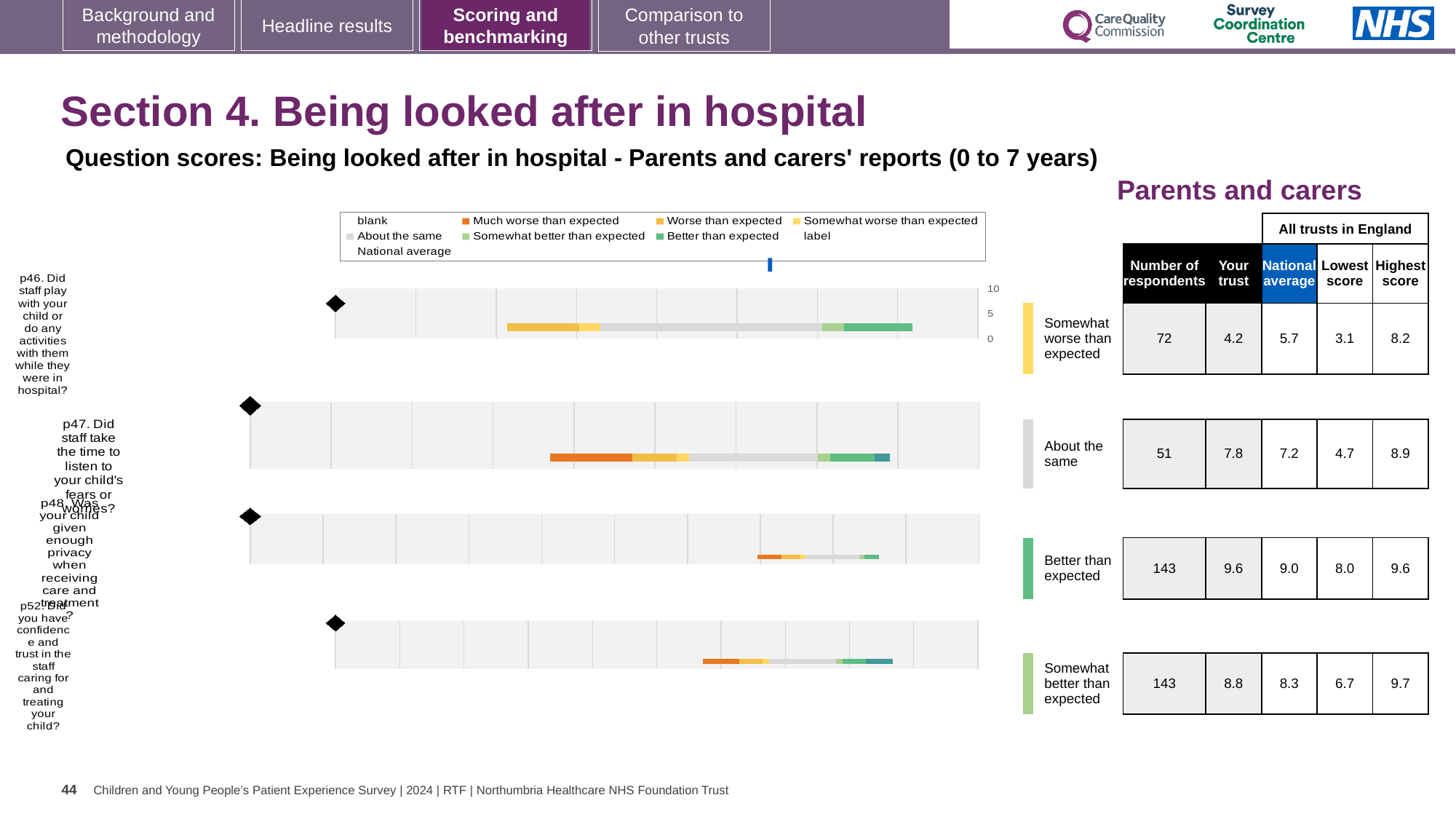
Which question chart has the lowest 'Your trust' score? p46 For the p46 chart, what is the difference between the national average (5.7) and the 'Your trust' score (4.2)? 1.5 For the p48 chart, which is larger: the 'Your trust' score or the national average? Your trust What kind of chart is used to show the question scores for p46 to p52? Bar chart What benchmark category is shown for the p46 chart? Somewhat worse than expected For the p47 chart (Did staff take the time to listen to your child's fears or worries?), what is the national average score? 7.2 For the p48 chart (Was your child given enough privacy when receiving care and treatment?), how many respondents are there? 143 For the p52 chart (Did you have confidence and trust in the staff caring for and treating your child?), what is the lowest score among all trusts in England? 6.7 For the p46 chart (Did staff play with your child or do any activities with them while they were in hospital?), what is the 'Your trust' score? 4.2 For the p46 chart, what is the highest score among all trusts in England? 8.2 Which question chart has the highest 'Your trust' score? p48 How many question charts (p46, p47, p48, p52) are shown on the slide? 4